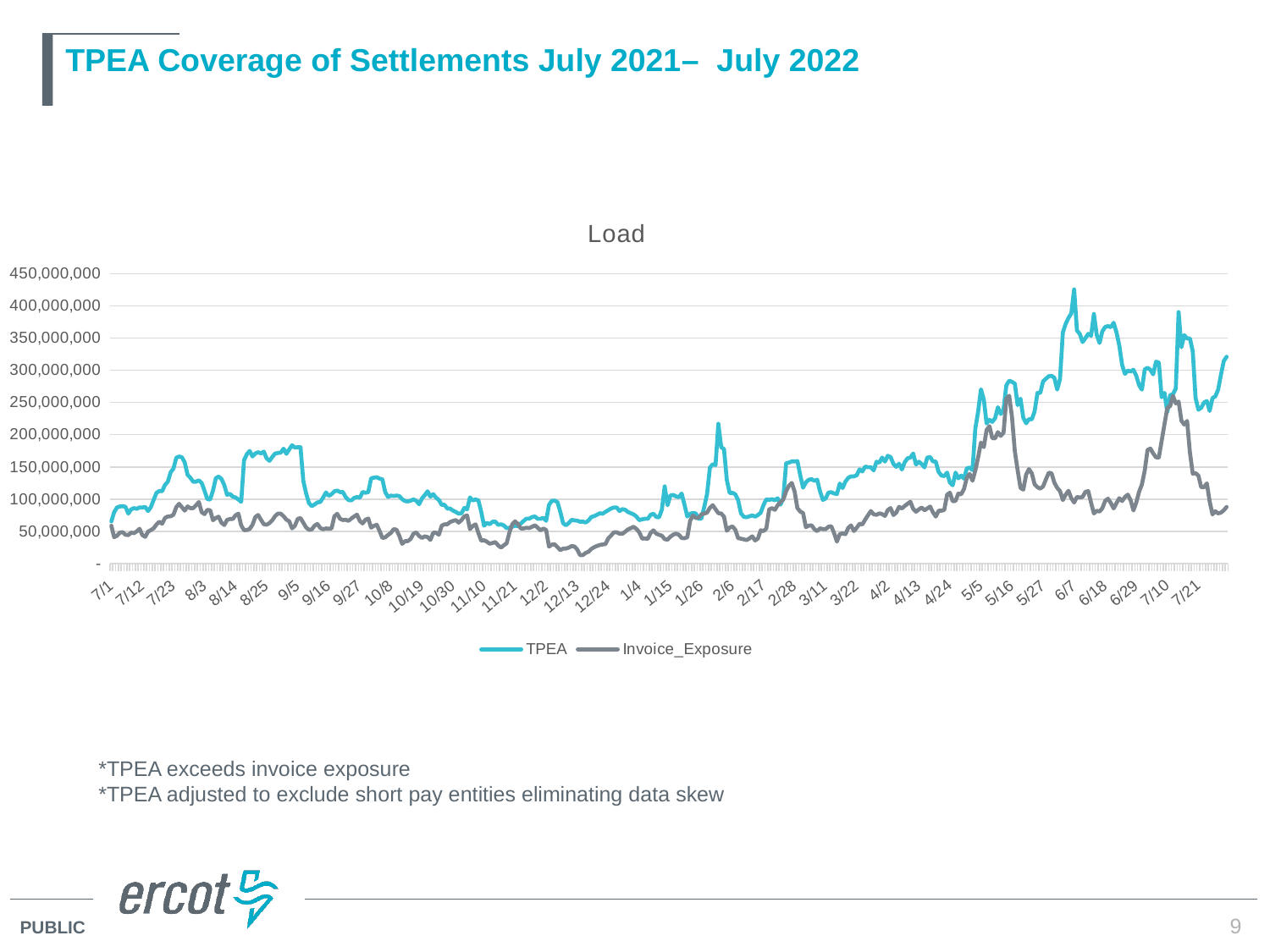
Is the value of Invoice_Exposure around 12/13 greater or less than 50,000,000? less Which series is higher at 6/7, TPEA or Invoice_Exposure? TPEA Is the peak value of TPEA around 6/7 greater or less than 400,000,000? greater What kind of chart is shown on the slide? Line chart Is the value of TPEA at 7/1 greater or less than 100,000,000? less What is the title of the chart? Load Which two series are listed in the legend? TPEA and Invoice_Exposure How many series does the legend list? 2 Which series reaches the highest value on the chart? TPEA